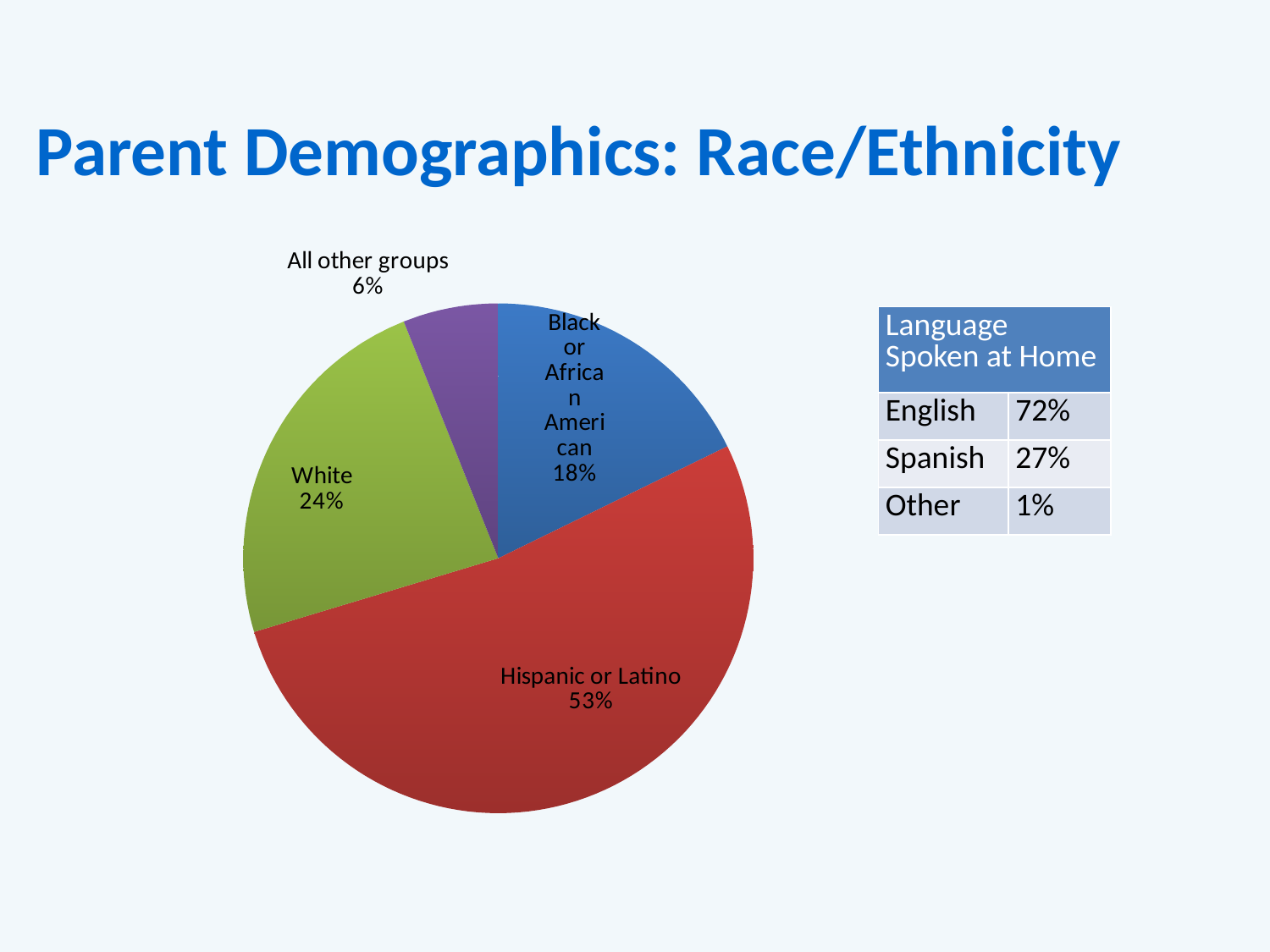
What colour is the Hispanic or Latino slice? red What kind of chart is shown on the slide? pie chart What share of the pie is Hispanic or Latino? 53% What percentage is shown for All other groups? 6% Which group has the largest slice of the pie? Hispanic or Latino What is the difference in percentage points between White and All other groups? 18 What percentage is shown for Black or African American? 18% How many slices does the pie chart have? 4 What is the difference in percentage points between Hispanic or Latino and White? 29 Which group has the smallest slice of the pie? All other groups What percentage is shown for White? 24% Which is larger, the White slice or the Black or African American slice? White